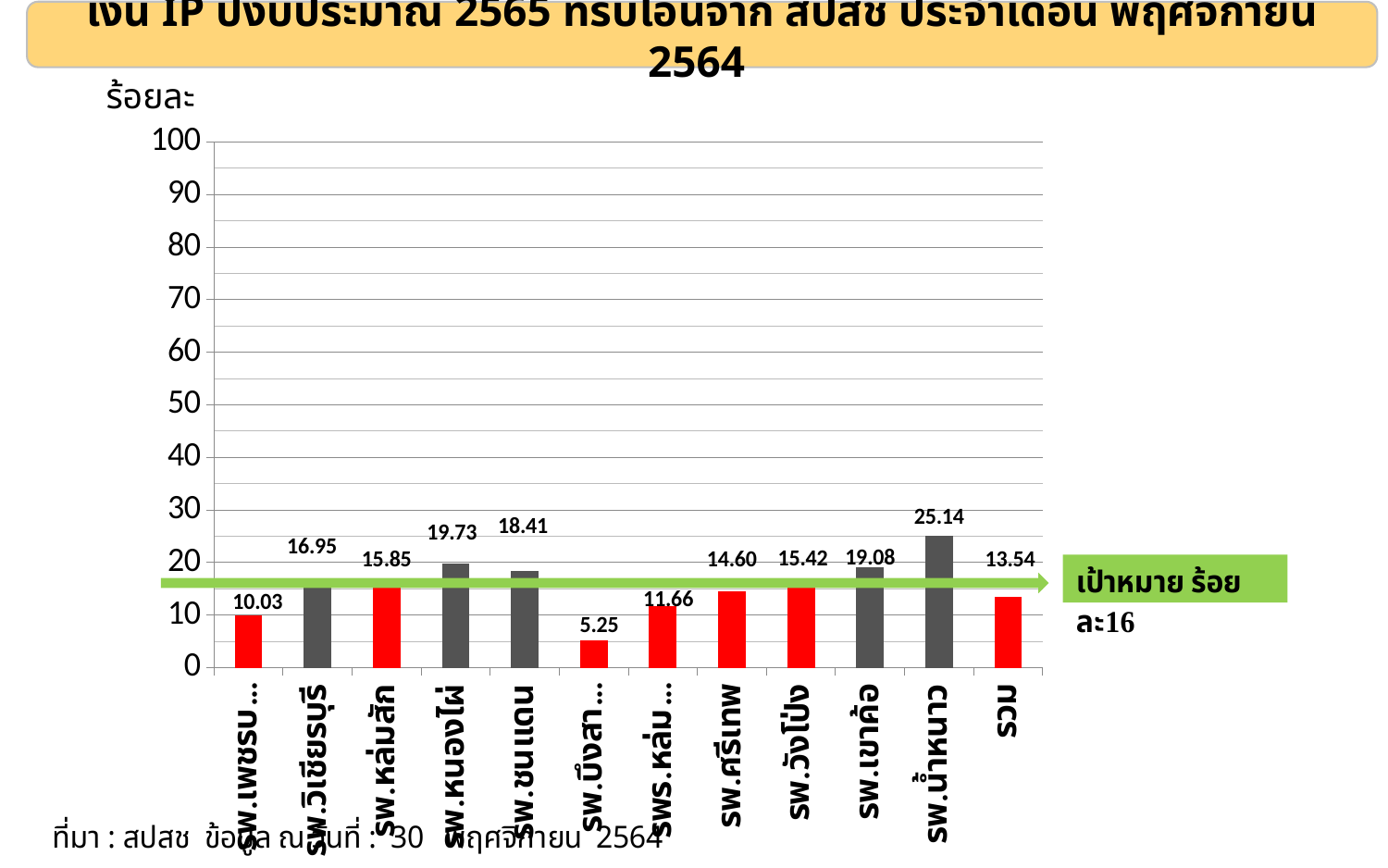
What is the difference between the values for รพ.น้ำหนาว and รวม? 11.60 What is the value for รวม? 13.54 Which is larger, the value for รพ.เขาค้อ or รพ.ศรีเทพ? รพ.เขาค้อ What is the value for รพ.หล่มสัก? 15.85 What kind of chart is shown on the slide? bar chart Which category has the highest value? รพ.น้ำหนาว What is the difference between the values for รพ.หนองไผ่ and รพ.ชนแดน? 1.32 What is the value for รพ.น้ำหนาว? 25.14 Is the value for รพ.น้ำหนาว greater or less than 20? greater How many bars are shown on the chart? 12 What is the value for รพ.วิเชียรบุรี? 16.95 What is the lowest value shown on the chart? 5.25